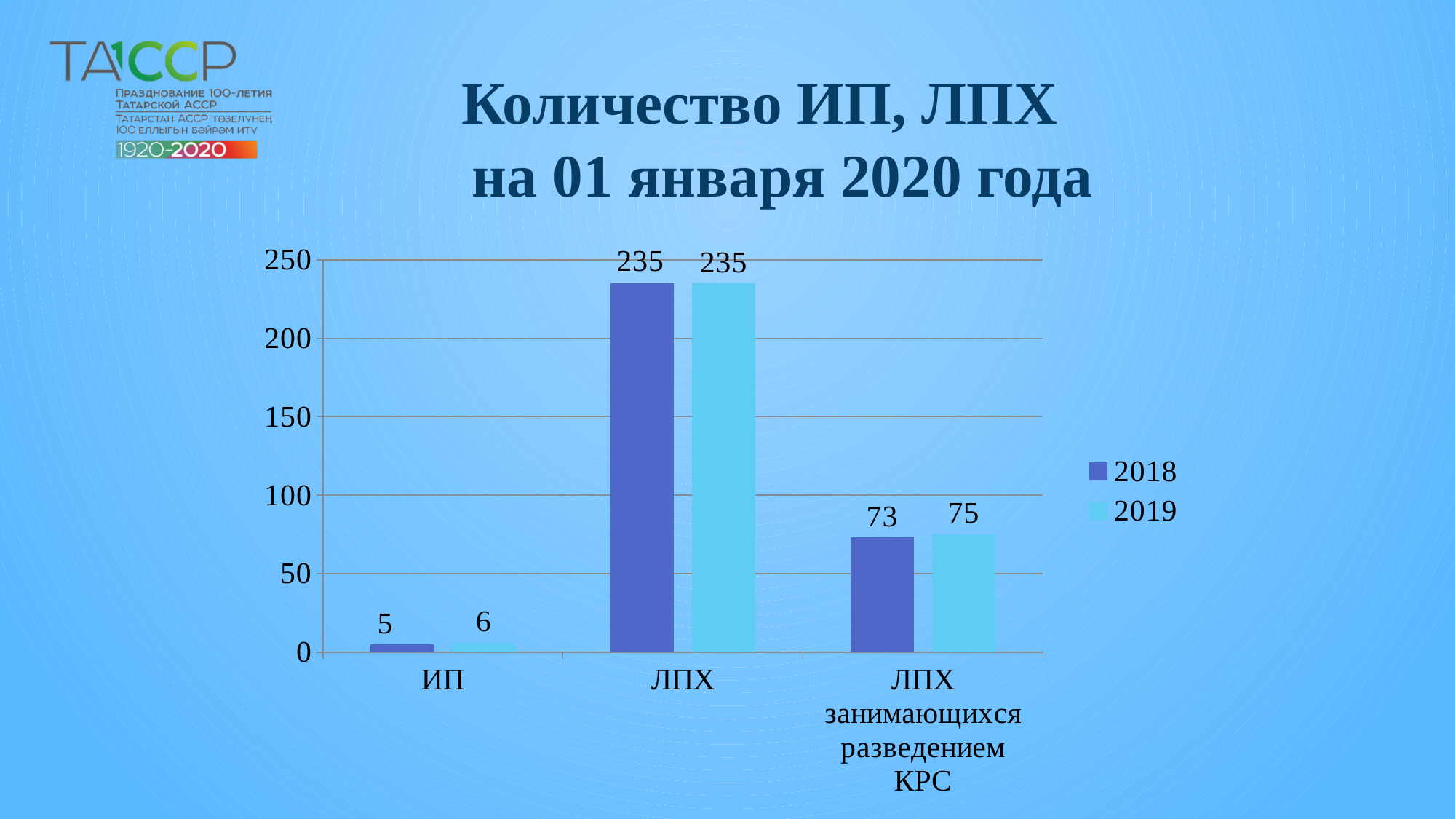
How many series does the legend list? 2 What kind of chart is shown on the slide? bar chart Which category has the highest value in 2019? ЛПХ What is the difference between the 2019 and 2018 values for ЛПХ занимающихся разведением КРС? 2 Which is larger for ЛПХ занимающихся разведением КРС: the 2018 value or the 2019 value? 2019 Which category has the lowest value in 2018? ИП What is the title of the chart? Количество ИП, ЛПХ на 01 января 2020 года What is the value for ИП in 2018? 5 What is the value for ЛПХ in 2019? 235 What is the value for ЛПХ занимающихся разведением КРС in 2018? 73 How many categories are shown on the x axis? 3 What is the value for ИП in 2019? 6